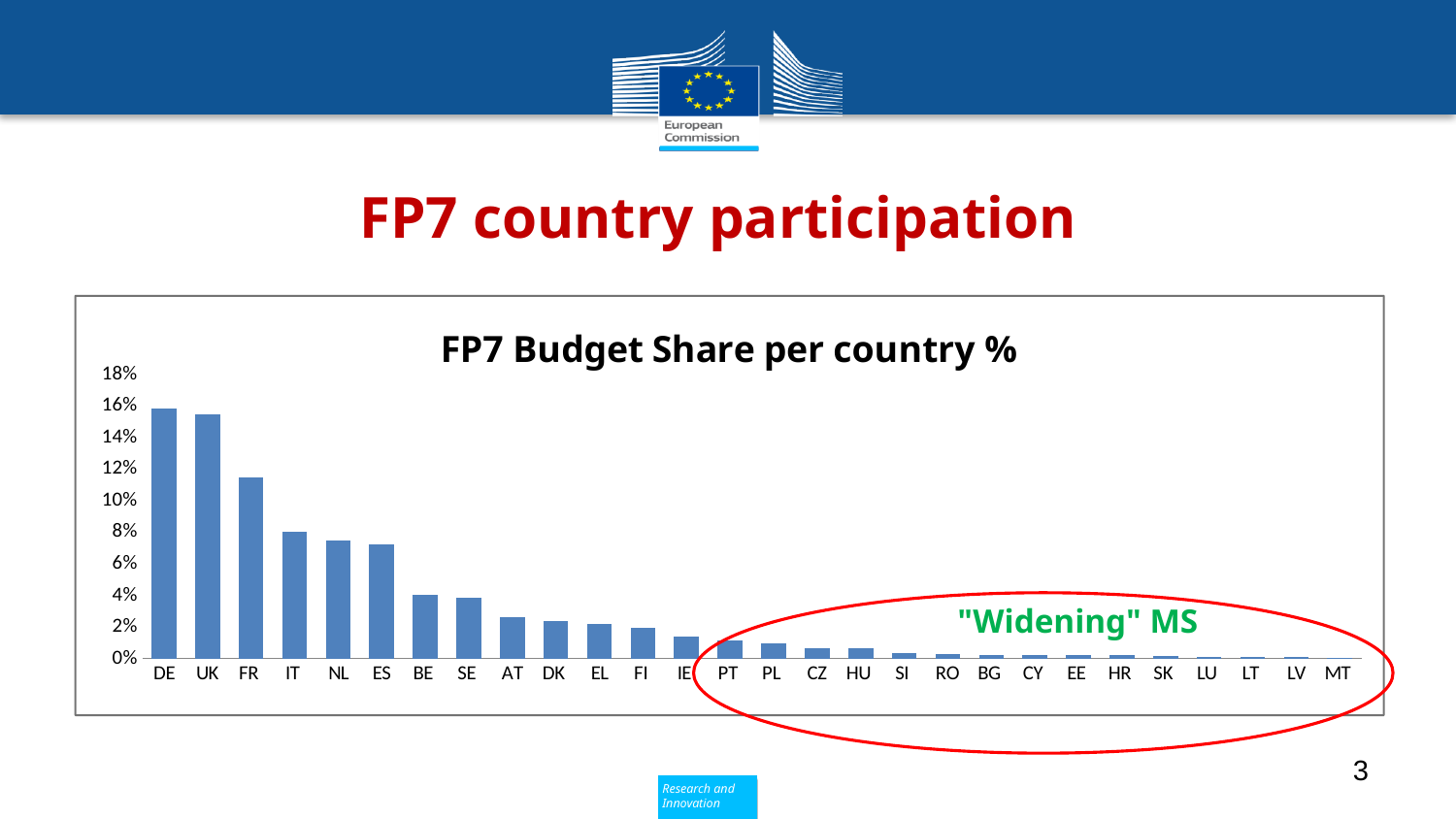
Which has a larger budget share, FR or IT? FR What is the title of the chart? FP7 Budget Share per country % Is the value for IT greater or less than 6%? greater Is the value for DE greater or less than 14%? greater Is the value for AT greater or less than 4%? less Which country has the highest FP7 budget share? DE What label is written inside the red oval on the chart? "Widening" MS What kind of chart is shown on the slide? bar chart How many countries are shown on the x axis of the chart? 28 Do the values rise or fall moving from left to right along the x axis? fall